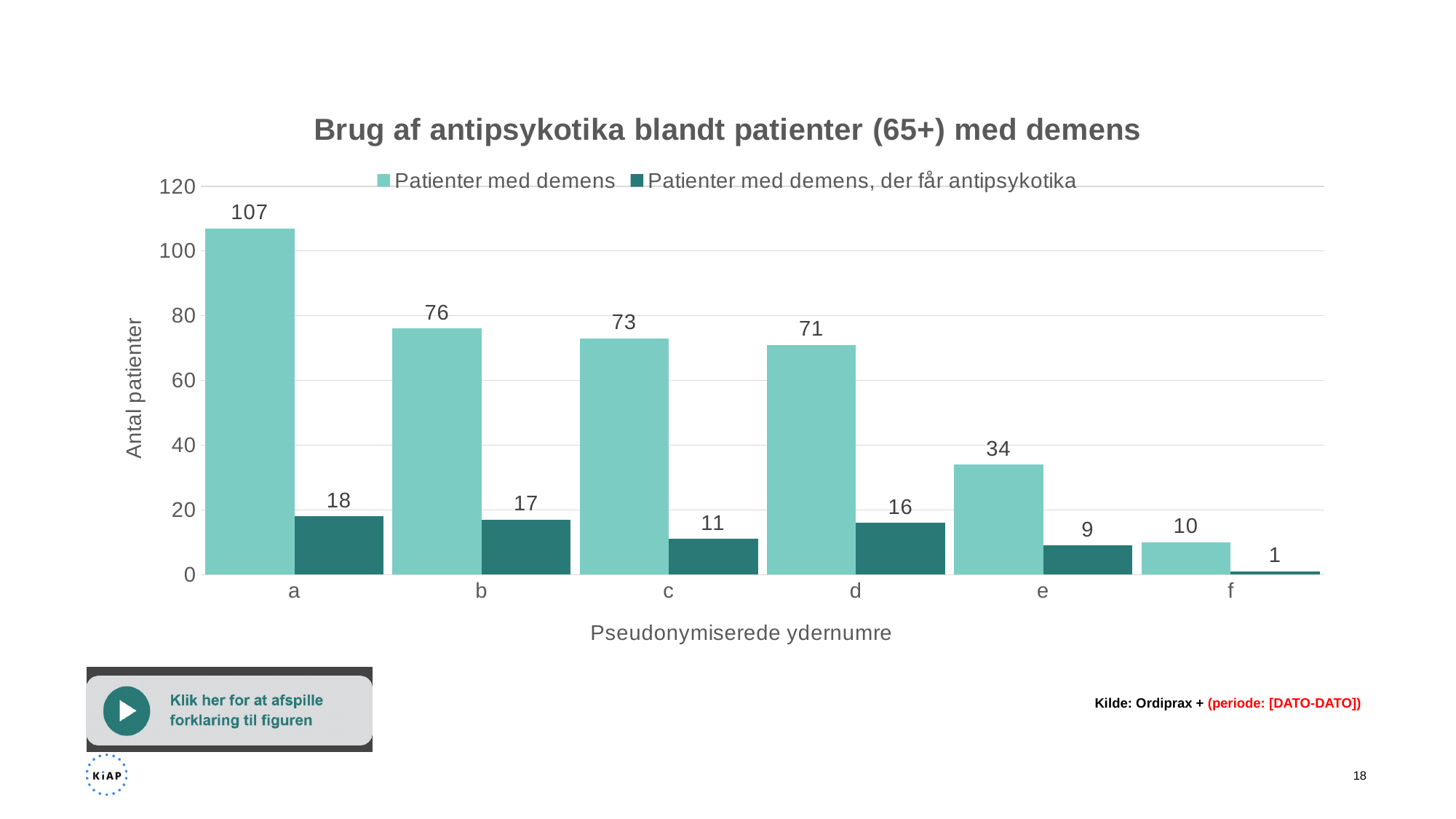
How many series does the legend list? 2 What is the difference between 'Patienter med demens' and 'Patienter med demens, der får antipsykotika' for category b? 59 What kind of chart is shown on the slide? bar chart What is the value of 'Patienter med demens, der får antipsykotika' for category c? 11 What is the title of the chart? Brug af antipsykotika blandt patienter (65+) med demens Is the value of 'Patienter med demens' for category d greater or less than 60? greater How many categories are shown on the x axis? 6 Which category has the lowest value for 'Patienter med demens, der får antipsykotika'? f What is the value of 'Patienter med demens' for category a? 107 What is the value of 'Patienter med demens' for category e? 34 Which is larger: 'Patienter med demens, der får antipsykotika' for category a or for category d? a Which category has the highest value for 'Patienter med demens'? a